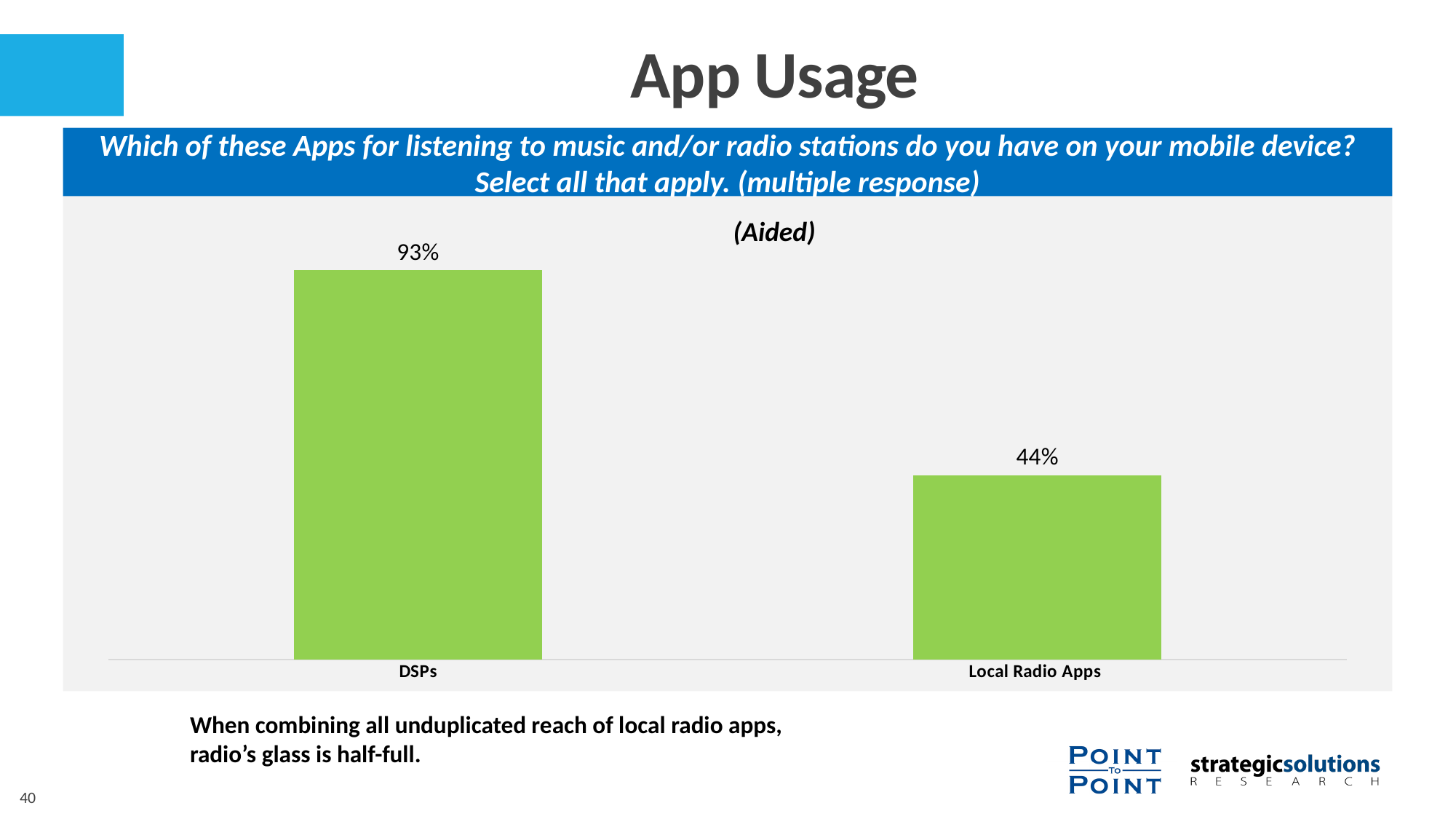
Which is larger, the value for DSPs or the value for Local Radio Apps? DSPs What colour are the bars in the chart? Green What is the difference in percentage points between DSPs and Local Radio Apps? 49 percentage points What kind of chart is shown on the slide? Bar chart What is the title of the slide? App Usage Which category has the highest value in the chart? DSPs What percentage of respondents have Local Radio Apps on their mobile device? 44% What percentage of respondents have DSPs on their mobile device? 93% Which category has the lowest value in the chart? Local Radio Apps How many categories are shown in the chart? 2